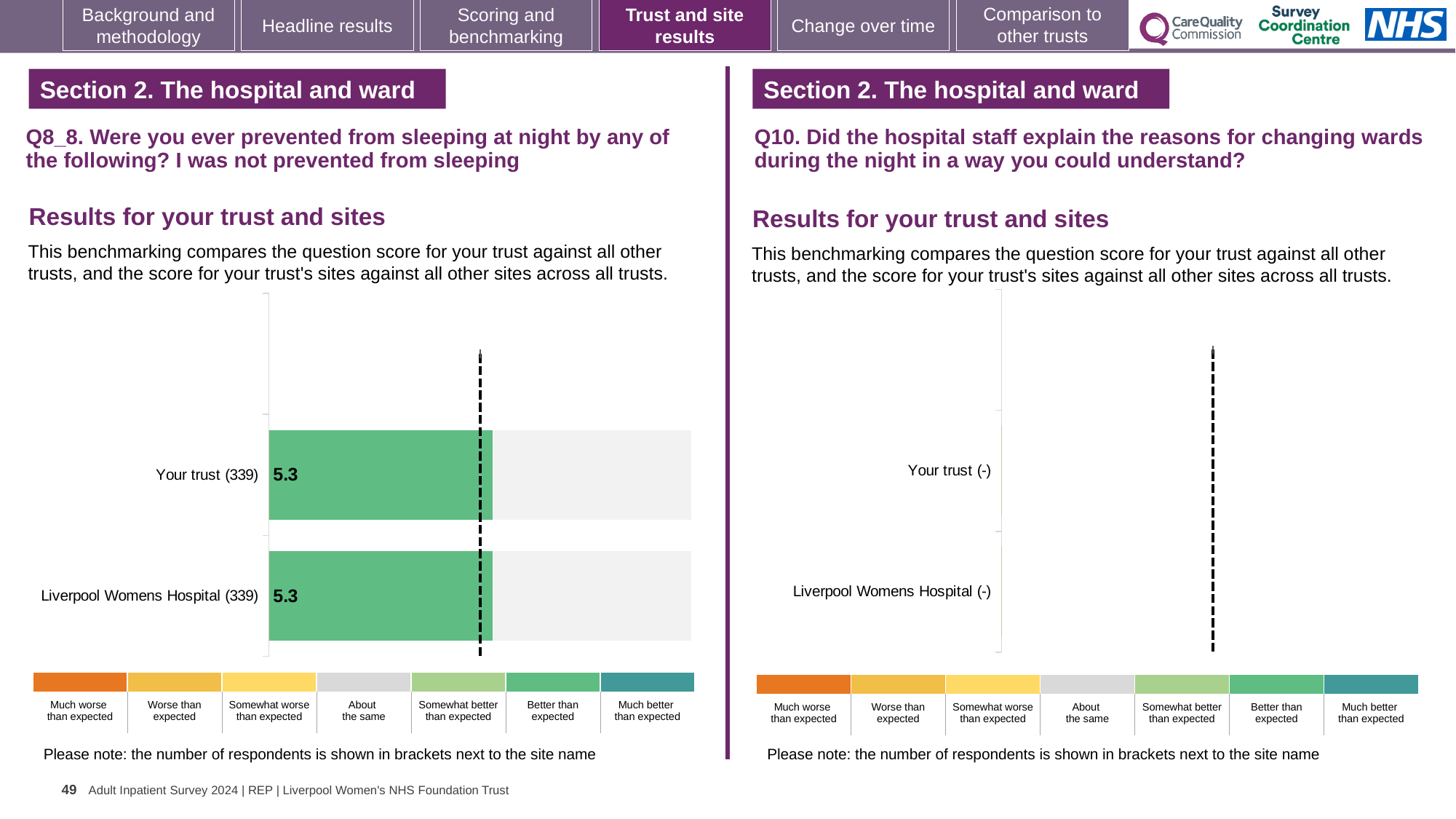
What kind of chart is shown on the left side of the slide (Q8_8)? Bar chart On the left chart (Q8_8), which colour category from the key do the bars fall into? Better than expected On the left chart (Q8_8), how many bars are plotted? 2 On the left chart (Q8_8), what is the score for Liverpool Womens Hospital? 5.3 On the left chart (Q8_8), is the score for Your trust greater or less than 5? greater On the right chart (Q10), what is shown in brackets next to Liverpool Womens Hospital? - On the left chart (Q8_8), what is the difference between the score for Your trust and the score for Liverpool Womens Hospital? 0.0 On the left chart (Q8_8), what is the score for Your trust? 5.3 On the right chart (Q10), how many categories are listed on the vertical axis? 2 On the left chart (Q8_8), how many respondents are shown in brackets next to Your trust? 339